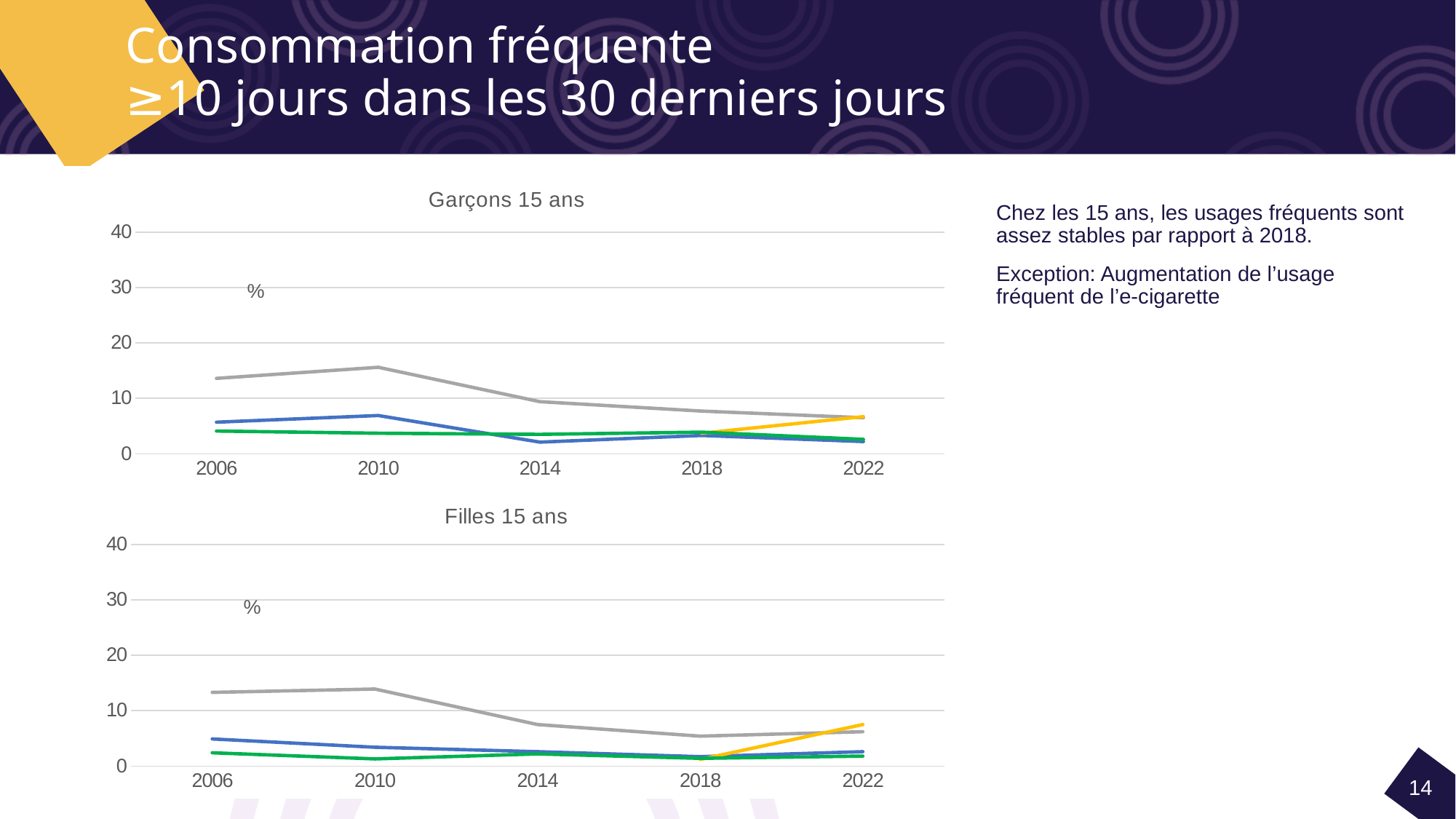
In the 'Garçons 15 ans' chart, is the value of the grey line in 2010 greater or less than 10? greater How many years are shown on the x axis of the 'Filles 15 ans' chart? 5 What kind of chart is the 'Garçons 15 ans' chart? line chart How many years are shown on the x axis of the 'Garçons 15 ans' chart? 5 What is the highest value shown on the y axis of the 'Filles 15 ans' chart? 40 In the 'Garçons 15 ans' chart, is the value of the grey line in 2022 greater or less than 10? less In the 'Filles 15 ans' chart, does the yellow line rise or fall between 2018 and 2022? rise What kind of chart is the 'Filles 15 ans' chart? line chart What is the title of the upper chart on the slide? Garçons 15 ans In the 'Garçons 15 ans' chart, does the grey line rise or fall between 2010 and 2022? fall In the 'Filles 15 ans' chart, is the value of the grey line in 2006 greater or less than 10? greater